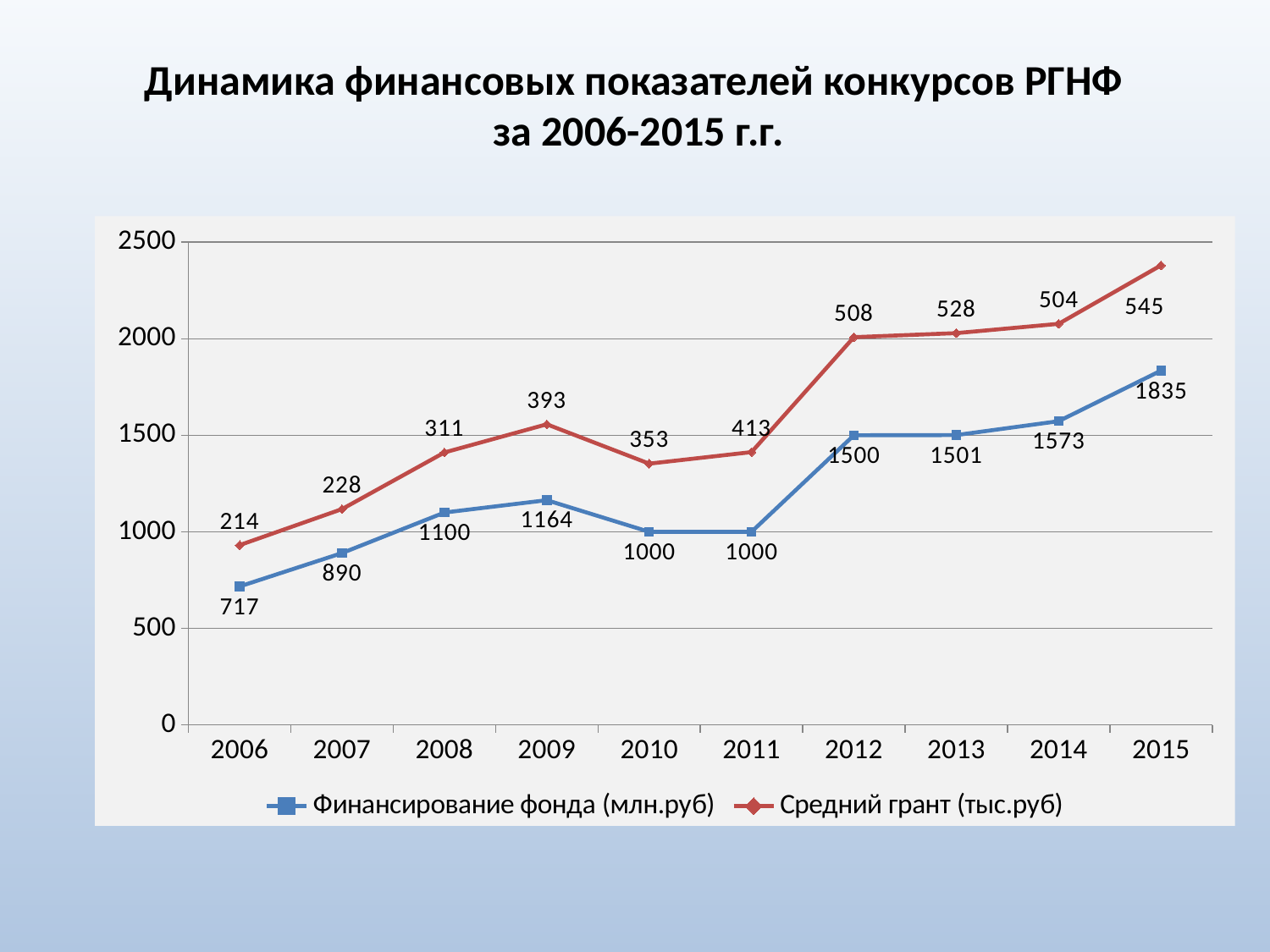
In which year is Финансирование фонда (млн.руб) highest? 2015 What is the labelled value of Средний грант (тыс.руб) in 2013? 528 Which is larger for Финансирование фонда (млн.руб): 2009 or 2010? 2009 What is the labelled value of Средний грант (тыс.руб) in 2009? 393 How many series does the legend list? 2 What is the value of Финансирование фонда (млн.руб) in 2006? 717 How many years are shown on the x axis? 10 What is the difference between Финансирование фонда (млн.руб) in 2015 and in 2014? 262 What type of chart is shown on the slide? line chart In which year is Финансирование фонда (млн.руб) lowest? 2006 What is the value of Финансирование фонда (млн.руб) in 2015? 1835 Is the value of Финансирование фонда (млн.руб) in 2012 greater or less than 1000? greater